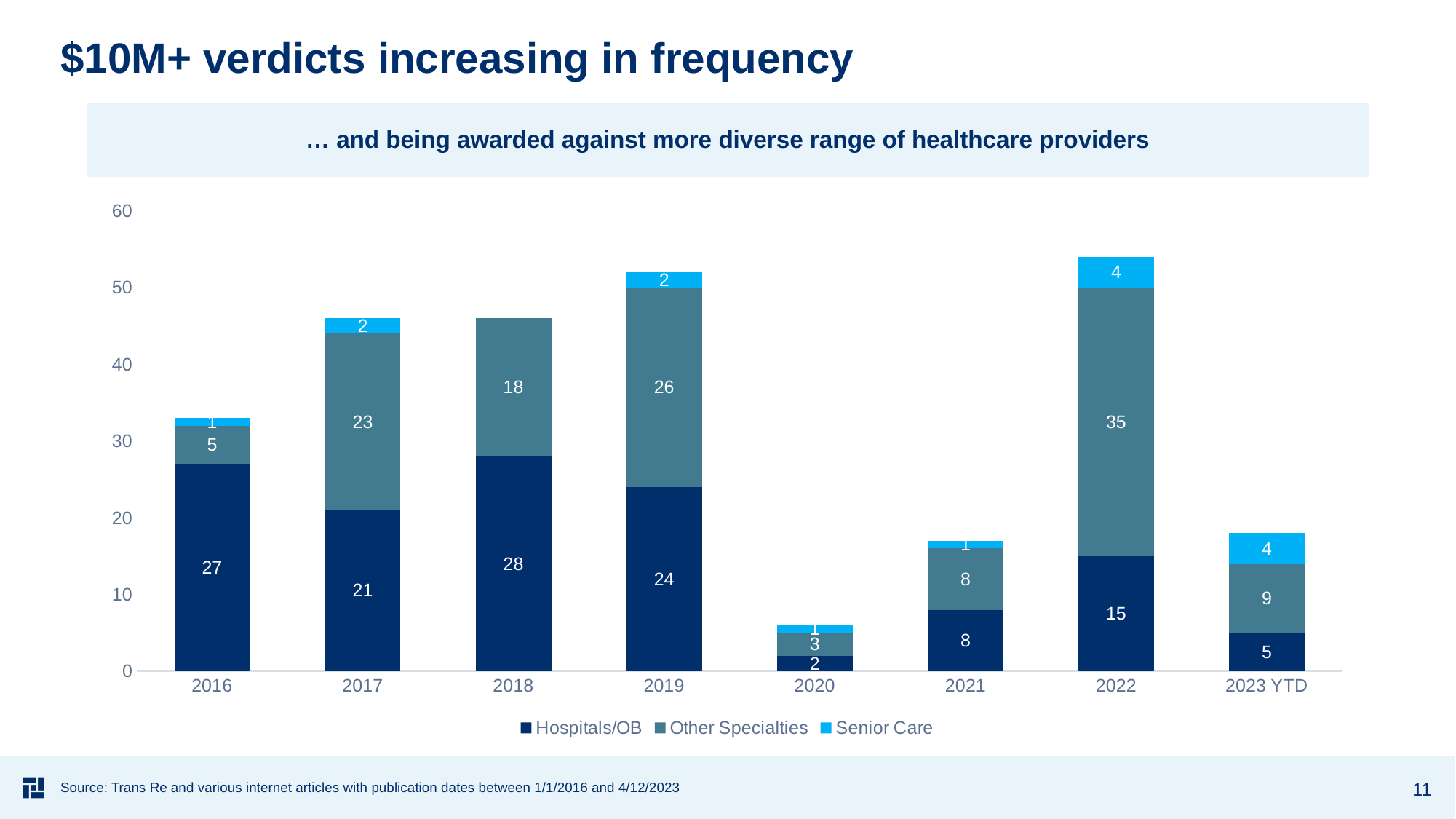
What is the total of the stacked bar for 2022? 54 What kind of chart is shown on the slide? Stacked bar chart What is the value for Hospitals/OB in 2018? 28 How many years are shown on the x axis? 8 What are the three series named in the legend? Hospitals/OB, Other Specialties, Senior Care What is the value for Senior Care in 2023 YTD? 4 What is the difference between the Other Specialties values for 2019 and 2018? 8 Which year has the lowest value for Hospitals/OB? 2020 Which year has the larger Hospitals/OB value, 2016 or 2017? 2016 What is the value for Other Specialties in 2022? 35 Which year has the highest value for Other Specialties? 2022 How many series does the legend list? 3